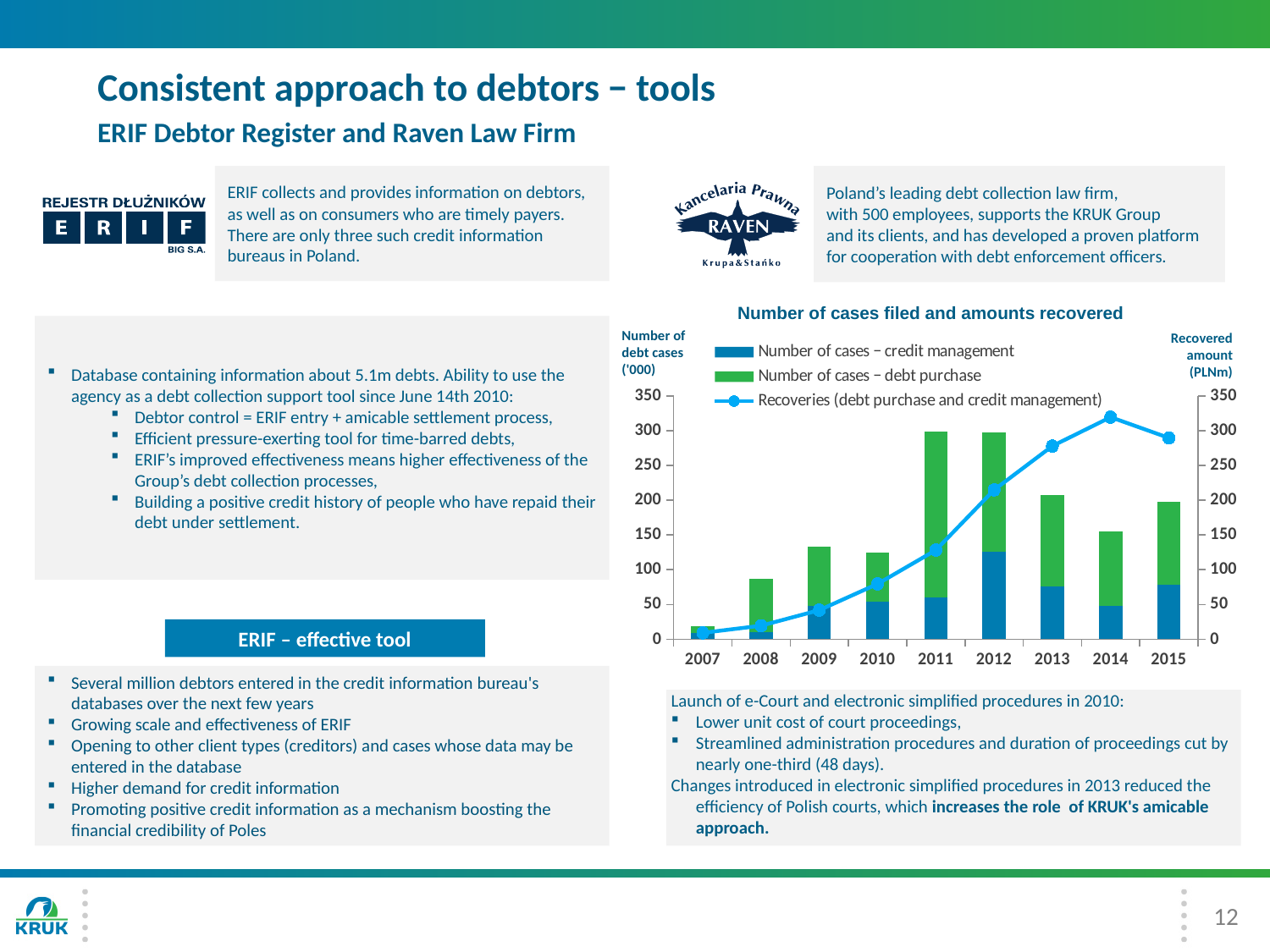
What is the title of the chart on the slide? Number of cases filed and amounts recovered What kind of chart is used for the number of cases series? Stacked bar chart (with a line for recoveries) Is the Recoveries value for 2014 greater or less than 300? greater Is the total number of debt cases in 2008 greater or less than 100? less Which year has the larger total number of debt cases, 2011 or 2013? 2011 How many years are shown on the x axis of the chart? 9 How many series does the chart legend list? 3 Which year has the lowest total number of debt cases? 2007 Is the number of cases for credit management in 2012 greater or less than 100? greater Do the Recoveries values rise or fall from 2007 to 2014? rise In which year is the Recoveries line at its highest? 2014